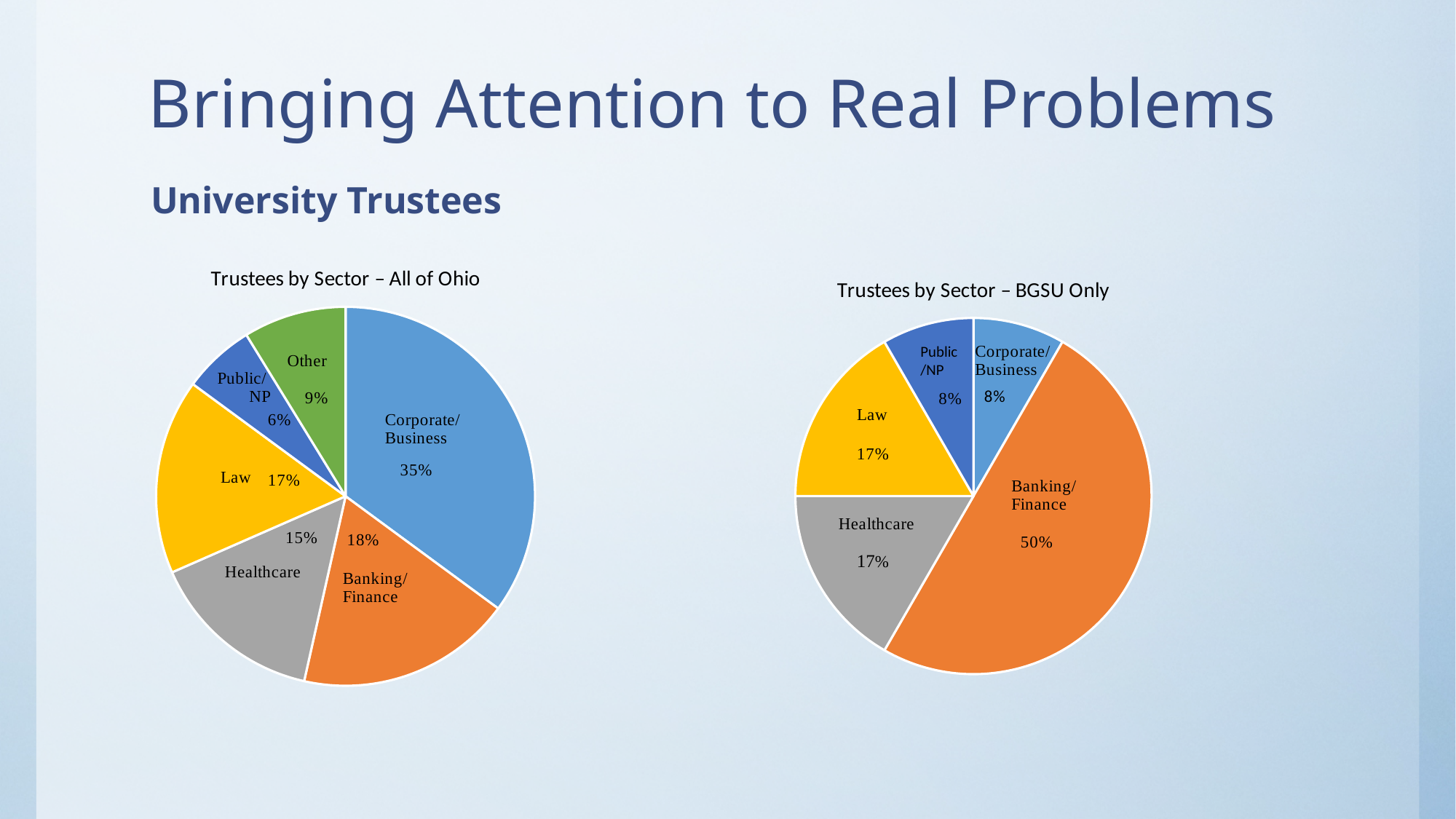
In the 'Trustees by Sector – All of Ohio' chart, what share of trustees is in Corporate/Business? 35% In the 'Trustees by Sector – All of Ohio' chart, which sector has the smallest slice? Public/NP In the 'Trustees by Sector – All of Ohio' chart, what is the difference between Corporate/Business and Banking/Finance? 17% In the 'Trustees by Sector – BGSU Only' chart, what is the value for Law? 17% In the 'Trustees by Sector – All of Ohio' chart, what is the value for Healthcare? 15% In the 'Trustees by Sector – BGSU Only' chart, which sector has the largest slice? Banking/Finance In the 'Trustees by Sector – BGSU Only' chart, what share of trustees is in Banking/Finance? 50% Which sector appears in the 'All of Ohio' chart but not in the 'BGSU Only' chart? Other Which is larger: Corporate/Business in the 'All of Ohio' chart or Corporate/Business in the 'BGSU Only' chart? All of Ohio What kind of chart is 'Trustees by Sector – BGSU Only'? Pie chart In the 'Trustees by Sector – BGSU Only' chart, how many sectors are shown? 5 In the 'Trustees by Sector – All of Ohio' chart, how many sectors are shown? 6